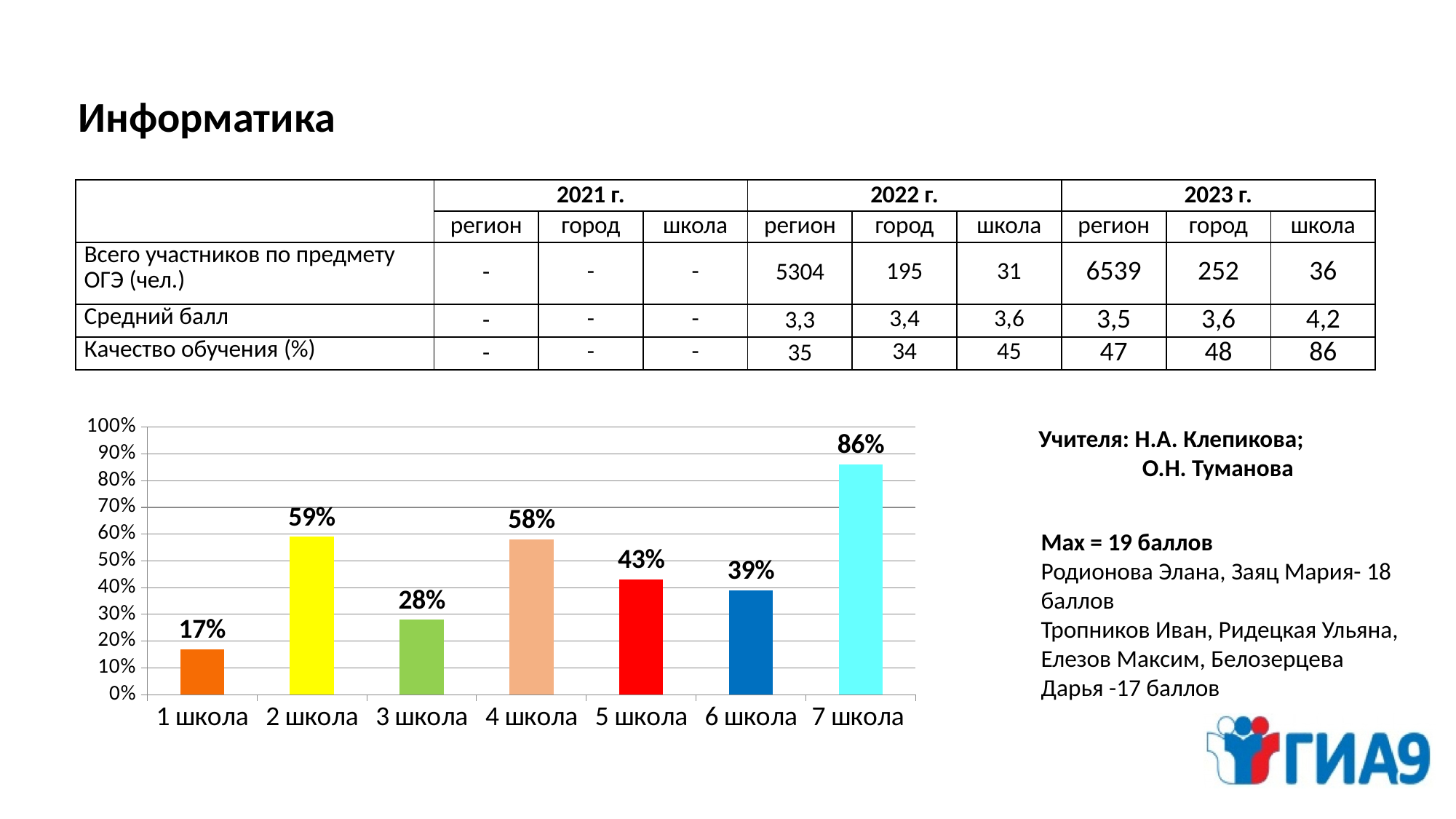
What is the difference between the values for 7 школа and 1 школа? 69% What is the value for 6 школа in the bar chart? 39% What is the value for 1 школа in the bar chart? 17% What kind of chart is shown on the slide? bar chart Is the value for 3 школа greater or less than 30%? less Which is larger, the value for 5 школа or the value for 6 школа? 5 школа Which school has the lowest value in the bar chart? 1 школа How many schools are shown on the x axis of the bar chart? 7 Which school has the highest value in the bar chart? 7 школа What colour is the bar for 5 школа? red What is the value for 4 школа in the bar chart? 58% What is the difference between the values for 2 школа and 3 школа? 31%